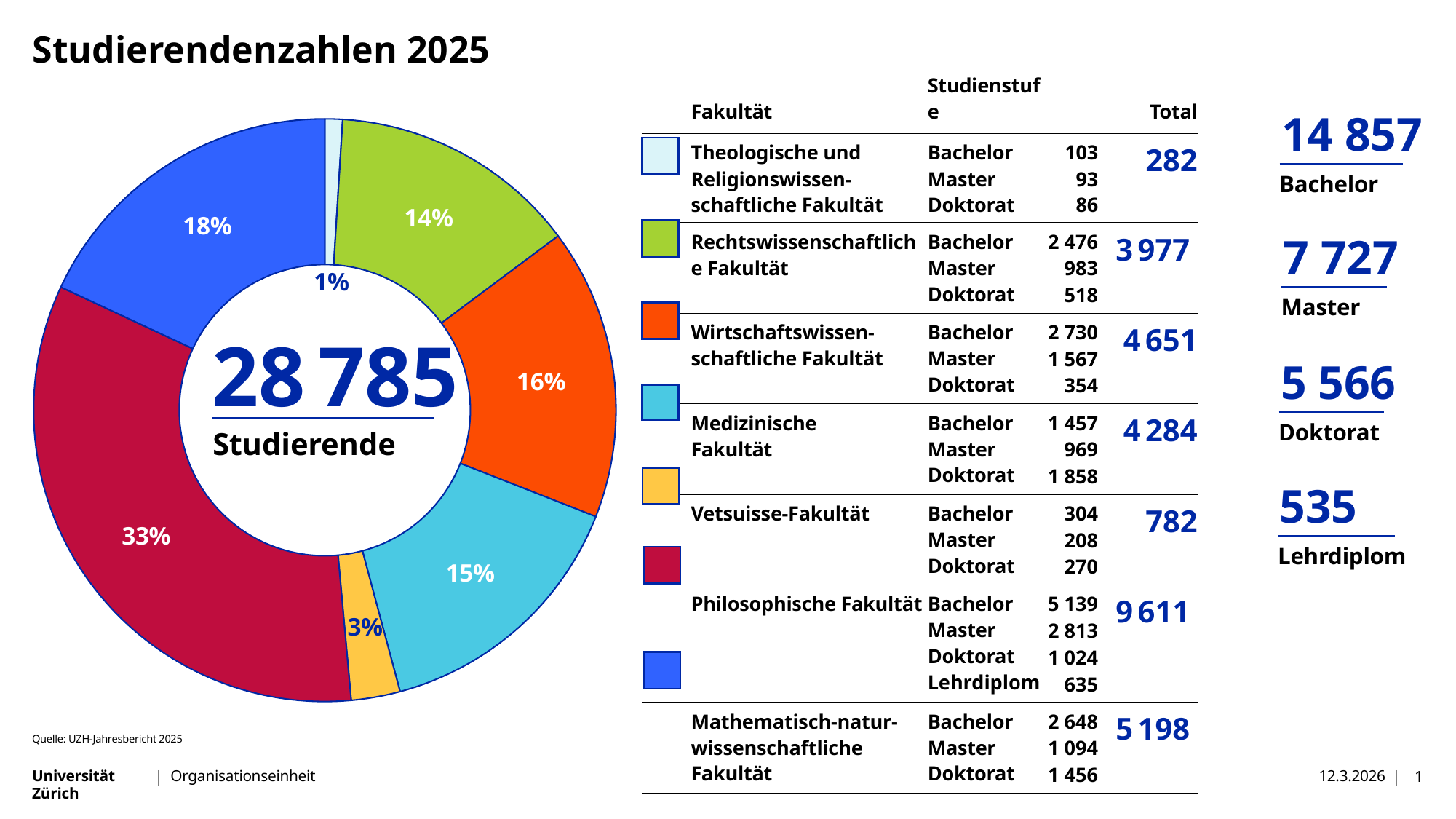
How many slices does the donut chart have? 7 What share of the donut chart does the Medizinische Fakultät (cyan slice) have? 15% What share of the donut chart does the Wirtschaftswissenschaftliche Fakultät (orange slice) have? 16% What total number of students is shown in the centre of the donut chart? 28 785 What share of the donut chart does the Philosophische Fakultät (red slice) have? 33% What colour is the slice representing the Mathematisch-naturwissenschaftliche Fakultät in the donut chart? Blue What is the difference in percentage points between the Philosophische Fakultät slice (33%) and the Mathematisch-naturwissenschaftliche Fakultät slice (18%)? 15 percentage points Which faculty has the largest slice in the donut chart? Philosophische Fakultät What kind of chart is shown on the slide? Pie chart (donut) Which faculty has the smallest slice in the donut chart? Theologische und Religionswissenschaftliche Fakultät Which slice is larger in the donut chart: Rechtswissenschaftliche Fakultät (green) or Wirtschaftswissenschaftliche Fakultät (orange)? Wirtschaftswissenschaftliche Fakultät